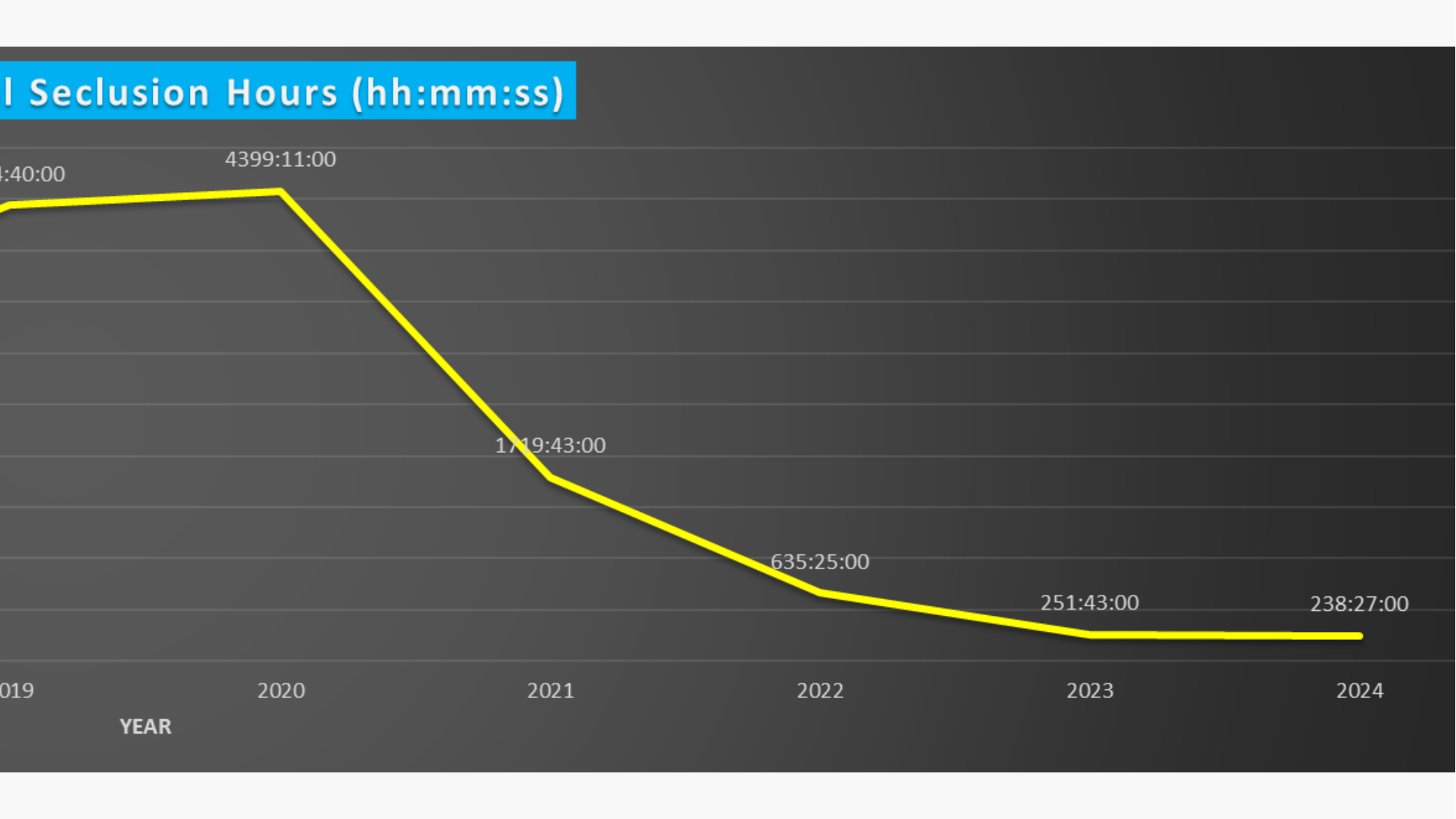
What is the value for 2022? 635:25:00 Do the values rise or fall from 2020 to 2024? fall Which is larger, the value for 2021 or the value for 2022? 2021 What is the title of the x axis? YEAR What is the difference between the values for 2023 and 2024? 13:16:00 What is the value for 2024? 238:27:00 What is the value for 2020? 4399:11:00 Which is larger, the value for 2022 or the value for 2023? 2022 What colour is the plotted line? yellow What is the value for 2023? 251:43:00 What kind of chart is shown on the slide? line chart Which year has the lowest value? 2024